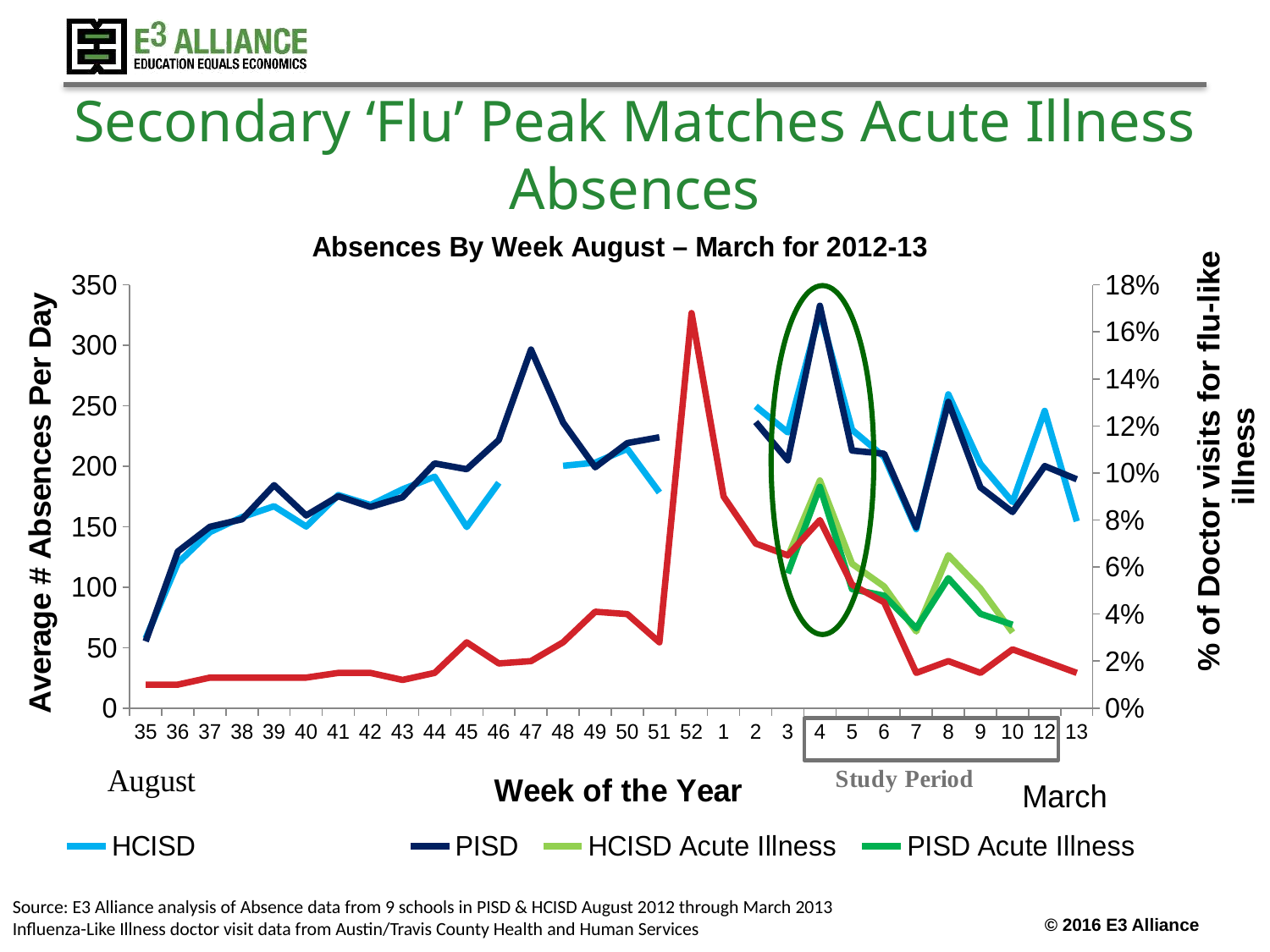
How many week labels are shown along the x axis? 30 Does the PISD series rise or fall from week 35 to week 39? Rise Is the PISD value at week 4 greater or less than 300? greater Is the HCISD value at week 35 greater or less than 100? less Which is larger for HCISD: the value at week 44 or the value at week 45? Week 44 What is the label of the left vertical axis? Average # Absences Per Day What is the title of the chart? Absences By Week August – March for 2012-13 What kind of chart is shown on the slide? Line chart Is the PISD value at week 7 greater or less than 200? less In which week does the PISD series reach its highest value? 4 How many series does the chart legend list? 4